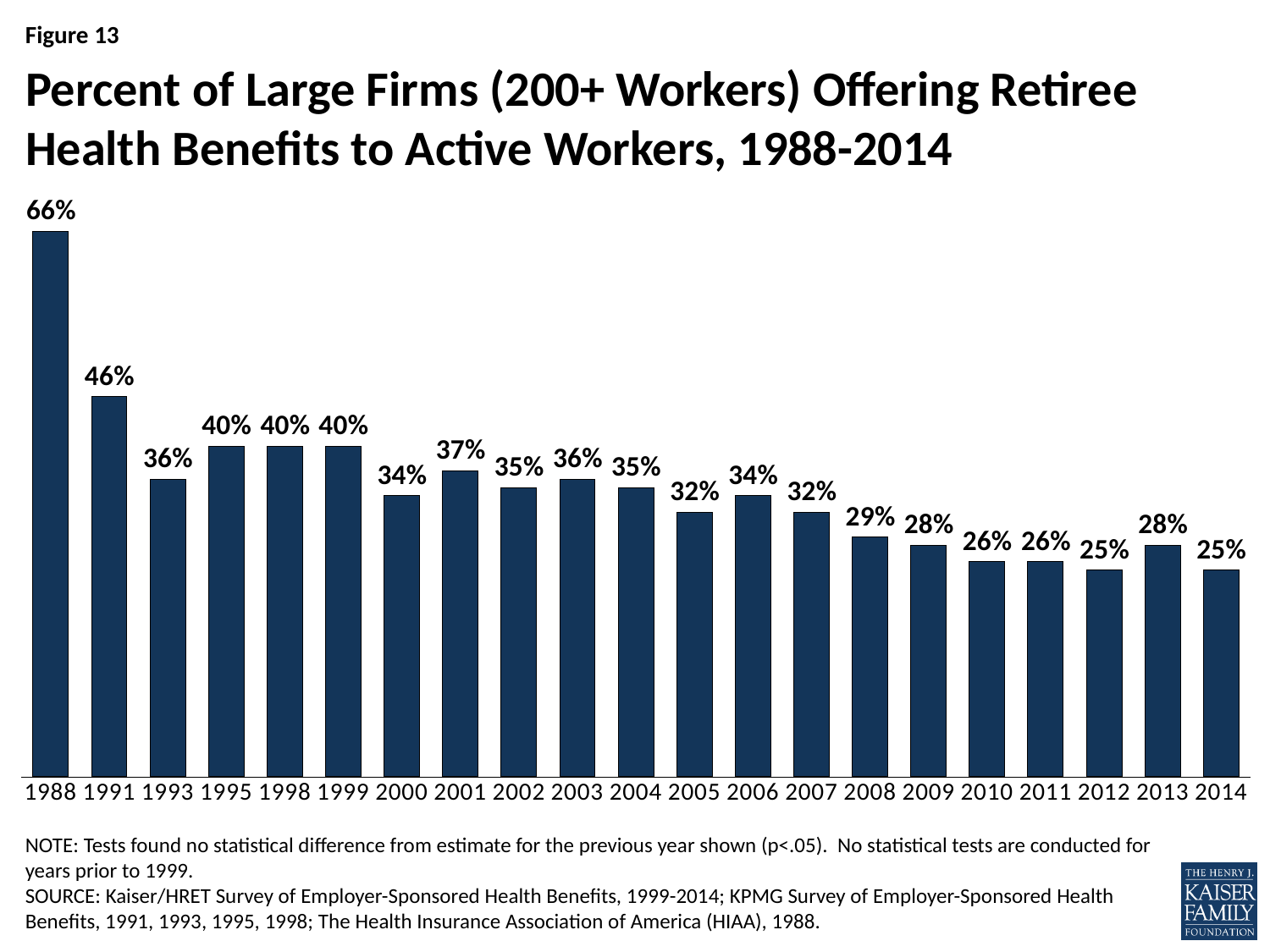
What percent of large firms offered retiree health benefits in 1988? 66% What type of chart is shown on the slide? Bar chart What is the lowest percentage shown on the chart? 25% Which year has the highest percentage of large firms offering retiree health benefits? 1988 Which year has a higher value, 2008 or 2013? 2008 What is the difference between the values for 1991 and 1993? 10 percentage points Do the values generally rise or fall from 1988 to 2014? Fall How many years are shown on the x axis of the chart? 21 What percent of large firms offered retiree health benefits in 2001? 37% What is the value shown for 2014? 25% Which year has a higher value, 2006 or 2007? 2006 What is the difference between the 1988 value and the 2014 value? 41 percentage points